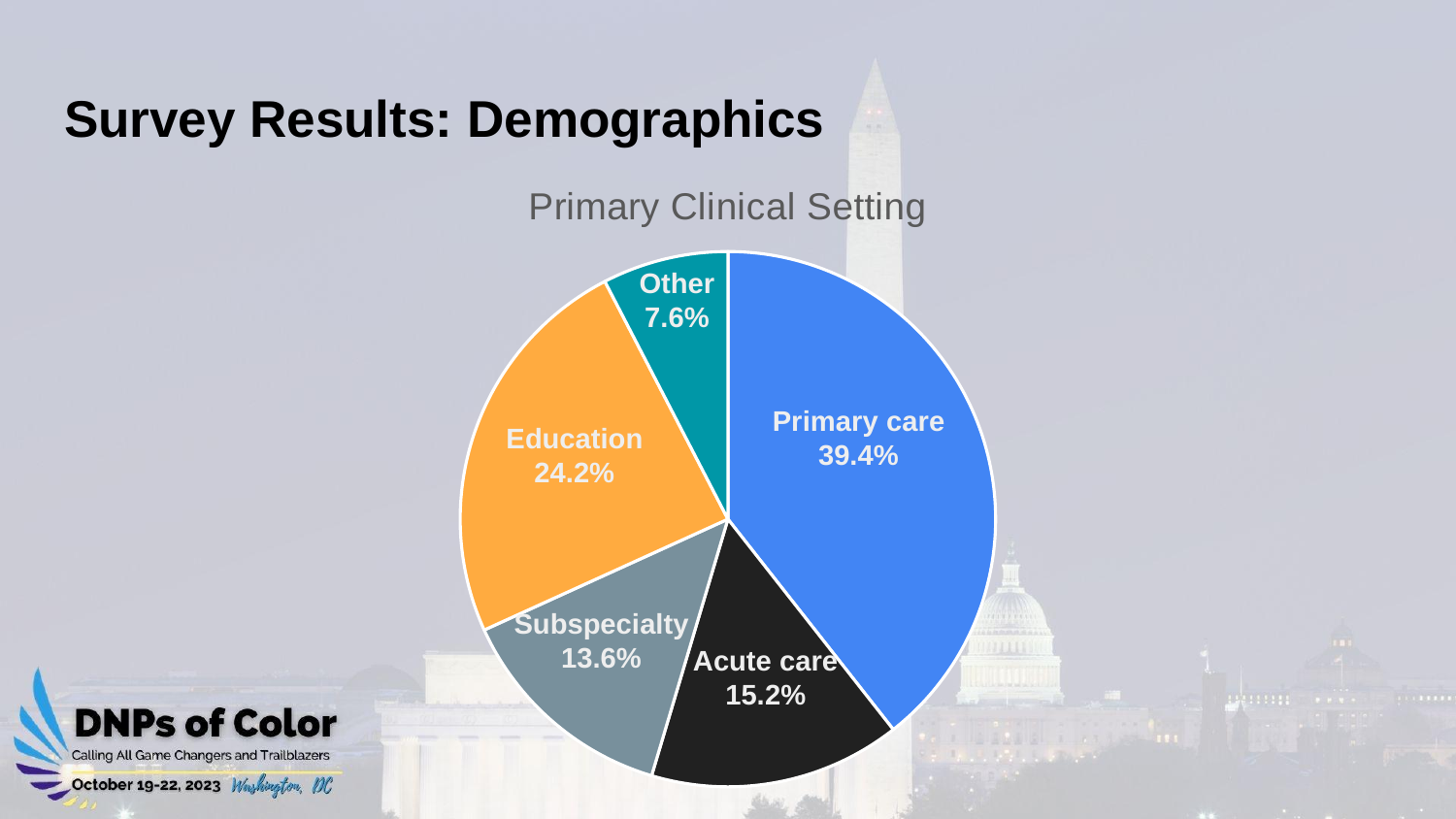
What share of the pie is Primary care? 39.4% Which is larger, Acute care or Subspecialty? Acute care What is the value for Acute care? 15.2% What is the title of the chart? Primary Clinical Setting Which category has the smallest slice? Other Which category has the largest slice? Primary care What is the value for Education? 24.2% What kind of chart is shown on the slide? pie chart What is the value for Other? 7.6% What is the difference between the Primary care and Education shares? 15.2% How many slices does the pie chart have? 5 What is the value for Subspecialty? 13.6%